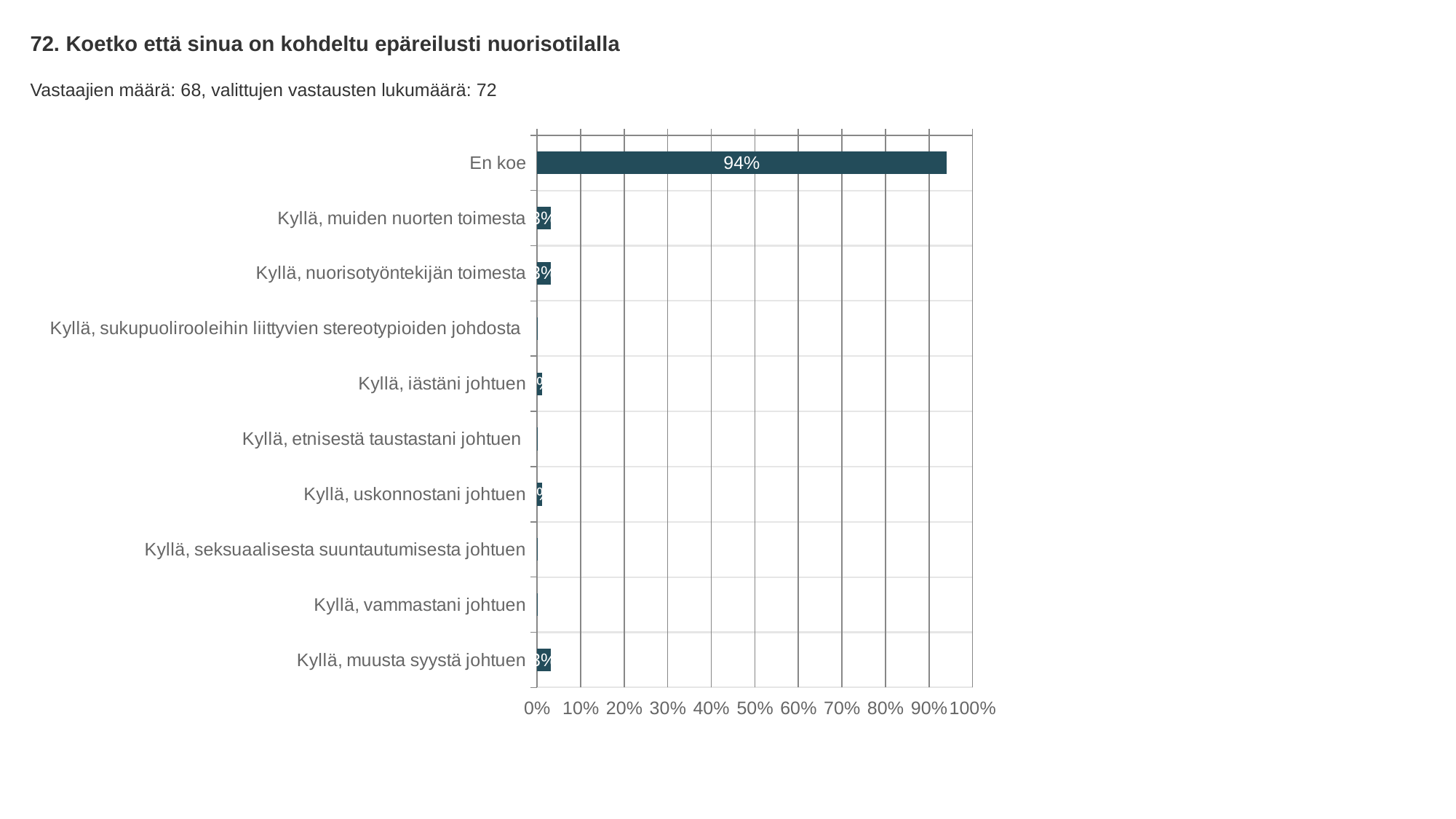
What is the highest value shown on the x axis? 100% Is the value for "En koe" greater or less than 90%? greater What is the value for "En koe"? 94% Which is larger, the value for "En koe" or the value for "Kyllä, nuorisotyöntekijän toimesta"? En koe Which category has the highest value? En koe How many categories are shown on the chart? 10 Is the value for "Kyllä, iästäni johtuen" greater or less than 50%? less What kind of chart is shown on the slide? Bar chart What is the title of the chart? 72. Koetko että sinua on kohdeltu epäreilusti nuorisotilalla Is the value for "Kyllä, muiden nuorten toimesta" greater or less than 10%? less